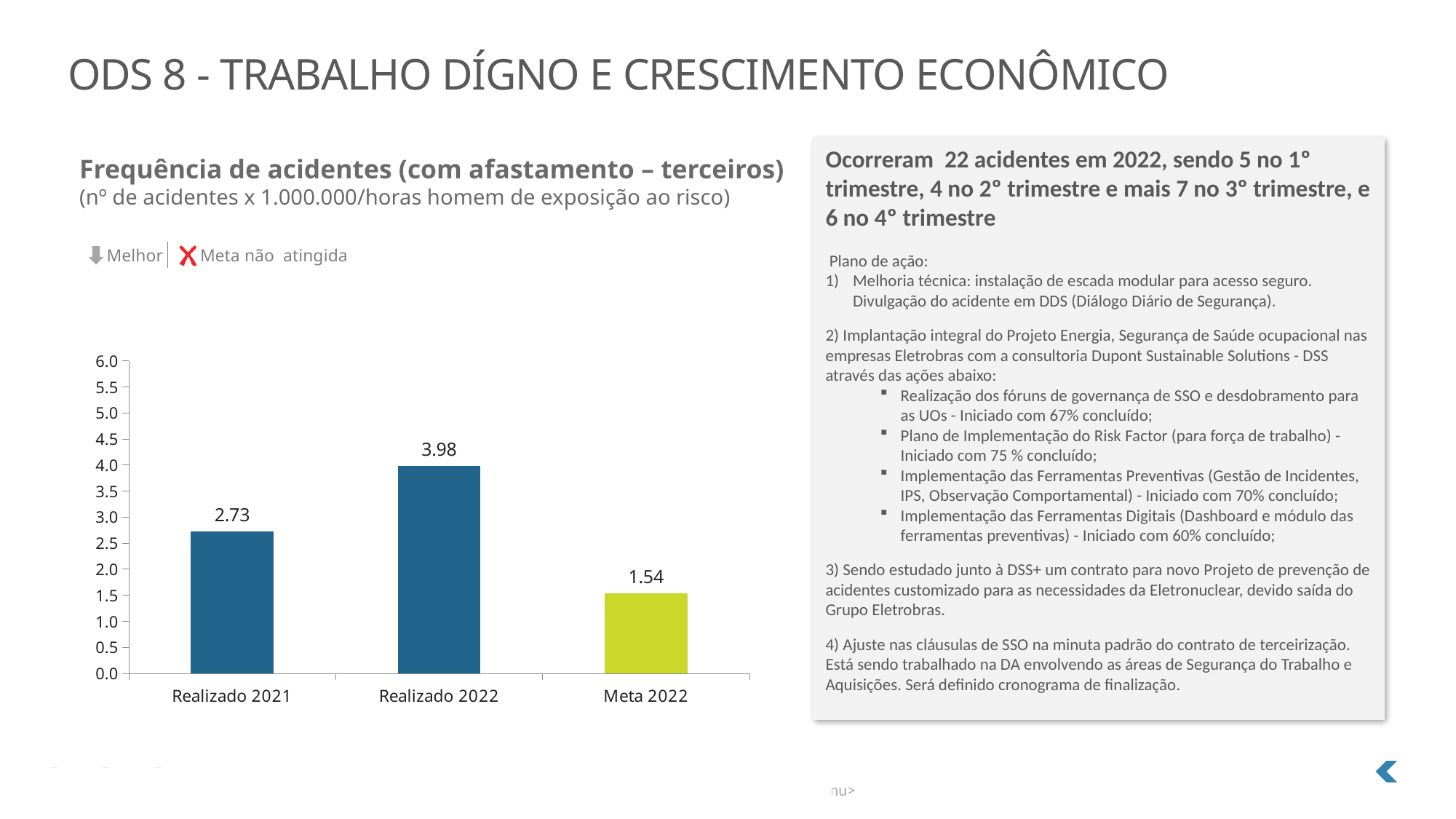
What is the title of the chart? Frequência de acidentes (com afastamento – terceiros) Which category has the lowest value? Meta 2022 What is the difference between Realizado 2022 and Meta 2022? 2.44 How many categories are shown on the x axis? 3 What is the value for Realizado 2021? 2.73 What is the value for Meta 2022? 1.54 What is the difference between Realizado 2022 and Realizado 2021? 1.25 Which category has the highest value? Realizado 2022 What is the value for Realizado 2022? 3.98 Which is larger, Realizado 2021 or Meta 2022? Realizado 2021 What kind of chart is shown? bar chart Is the value for Realizado 2022 greater or less than 3.5? greater